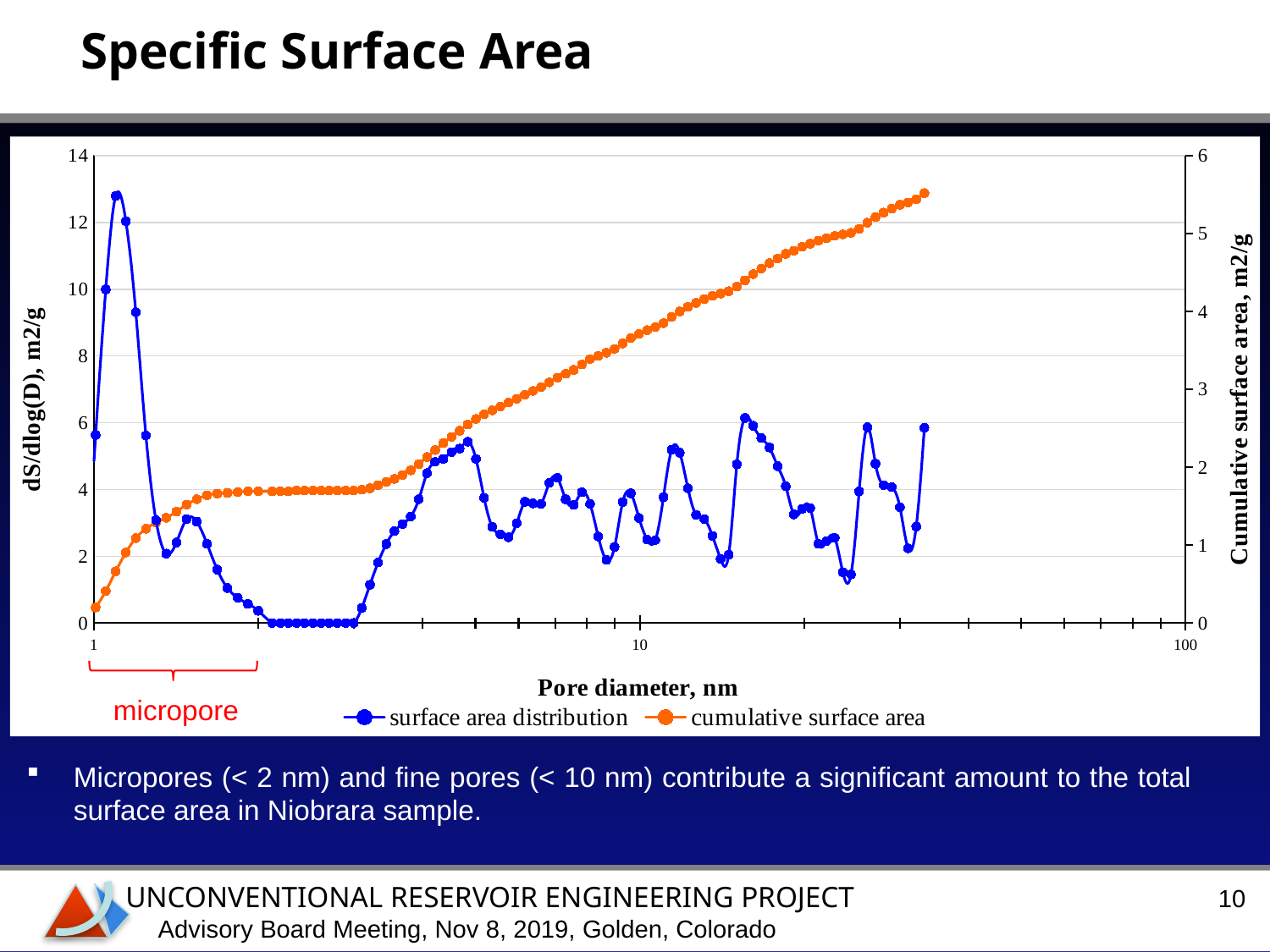
Which series is plotted in orange? cumulative surface area Is the final (rightmost) value of the cumulative surface area series greater or less than 5 m2/g? greater What is the highest tick value shown on the left y axis (dS/dlog(D), m2/g)? 14 Is the peak value of the surface area distribution series greater or less than 12 m2/g? greater Is the cumulative surface area at a pore diameter of 10 nm greater or less than 4 m2/g? less What is the title of the x axis of the chart? Pore diameter, nm How many series does the chart legend list? 2 What kind of chart is shown on the slide? line chart What are the two series named in the chart legend? surface area distribution; cumulative surface area What is the highest tick value shown on the right y axis (Cumulative surface area, m2/g)? 6 Does the cumulative surface area series rise or fall as pore diameter increases along the x axis? rise